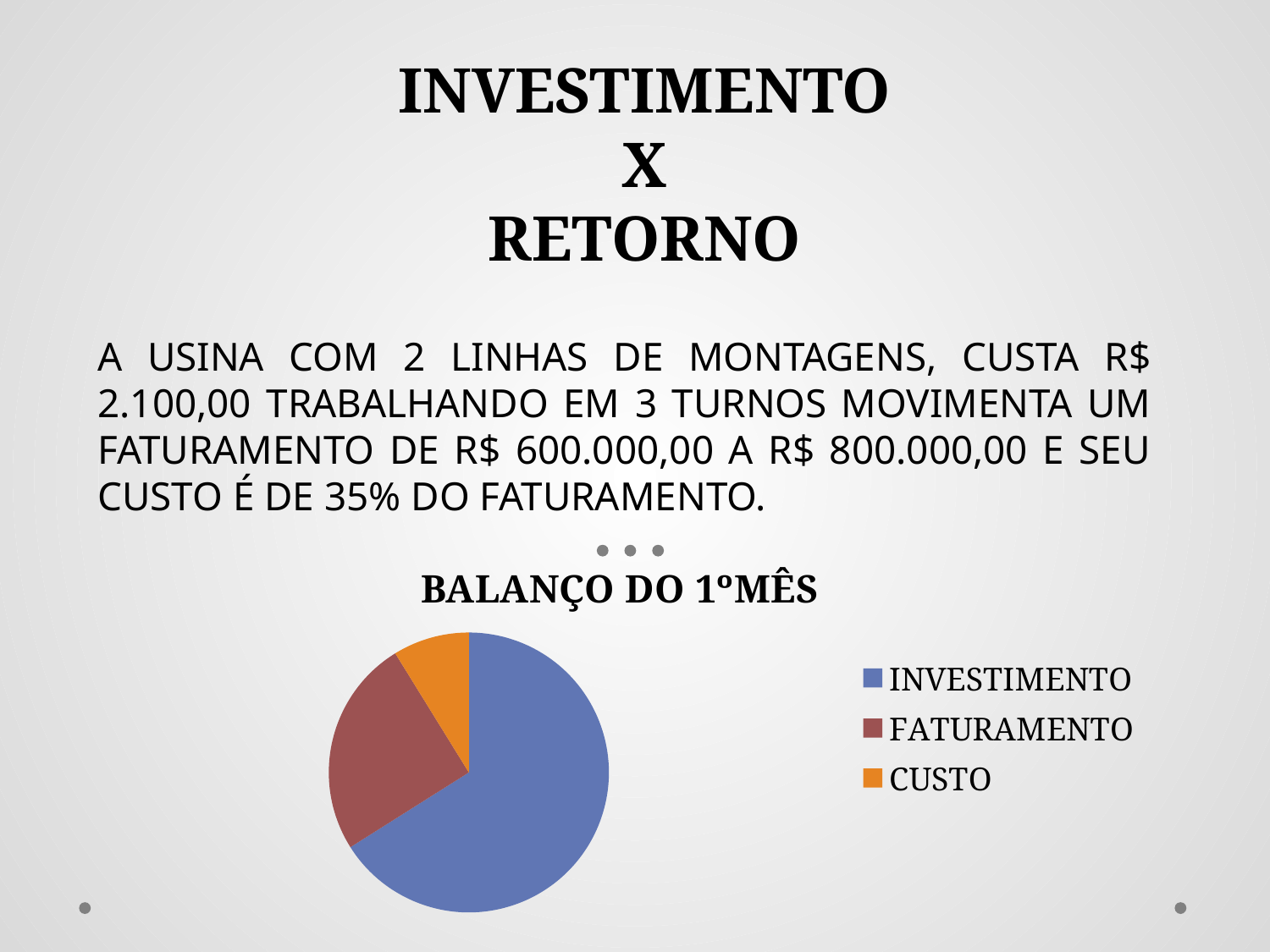
How many slices does the pie chart have? 3 How many entries does the chart legend list? 3 Which slice is larger, FATURAMENTO or CUSTO? FATURAMENTO Does the INVESTIMENTO slice take up more or less than half of the pie? more Which category has the smallest slice of the pie? CUSTO Which slice is larger, INVESTIMENTO or FATURAMENTO? INVESTIMENTO What is the title of the chart? BALANÇO DO 1ºMÊS Which category has the largest slice of the pie? INVESTIMENTO Which colour represents CUSTO in the pie chart? orange What kind of chart is shown on the slide? pie chart